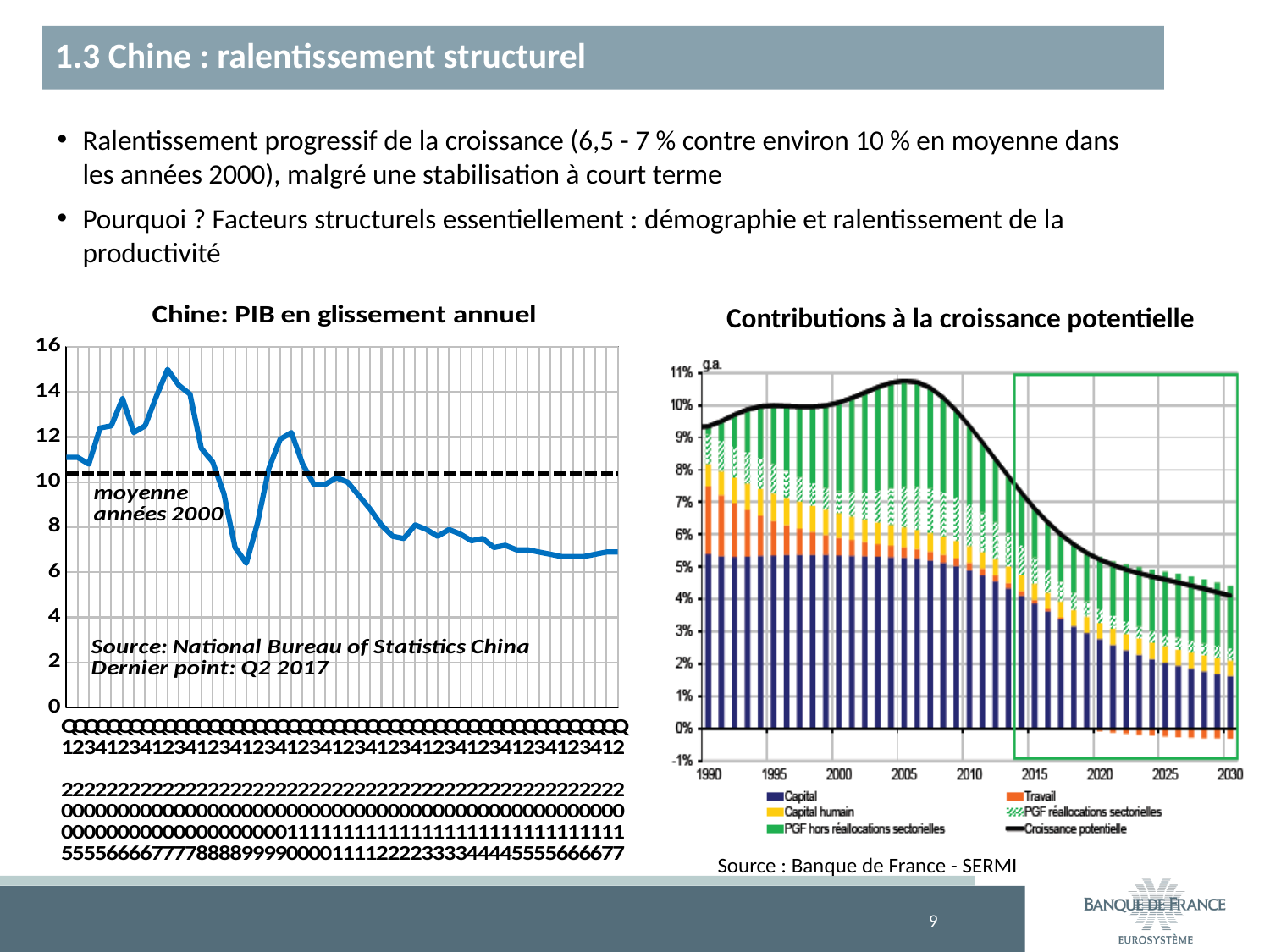
What kind of chart is the left chart titled "Chine: PIB en glissement annuel"? line chart In the right chart "Contributions à la croissance potentielle", does the Croissance potentielle line rise or fall between 2010 and 2030? fall In the right chart "Contributions à la croissance potentielle", is the Croissance potentielle line around 2005 greater or less than 10%? greater What kind of chart is the right chart titled "Contributions à la croissance potentielle"? stacked bar chart with a line In the right chart "Contributions à la croissance potentielle", which legend entry is drawn as a black line? Croissance potentielle In the left chart "Chine: PIB en glissement annuel", is the last point (Q2 2017) greater or less than 8? less How many entries does the legend of the right chart "Contributions à la croissance potentielle" list? 6 In the left chart "Chine: PIB en glissement annuel", what does the dashed horizontal line represent? moyenne années 2000 In the left chart "Chine: PIB en glissement annuel", does the line overall rise or fall between 2010 and 2017? fall In the left chart "Chine: PIB en glissement annuel", is the dashed "moyenne années 2000" line above or below 10? above